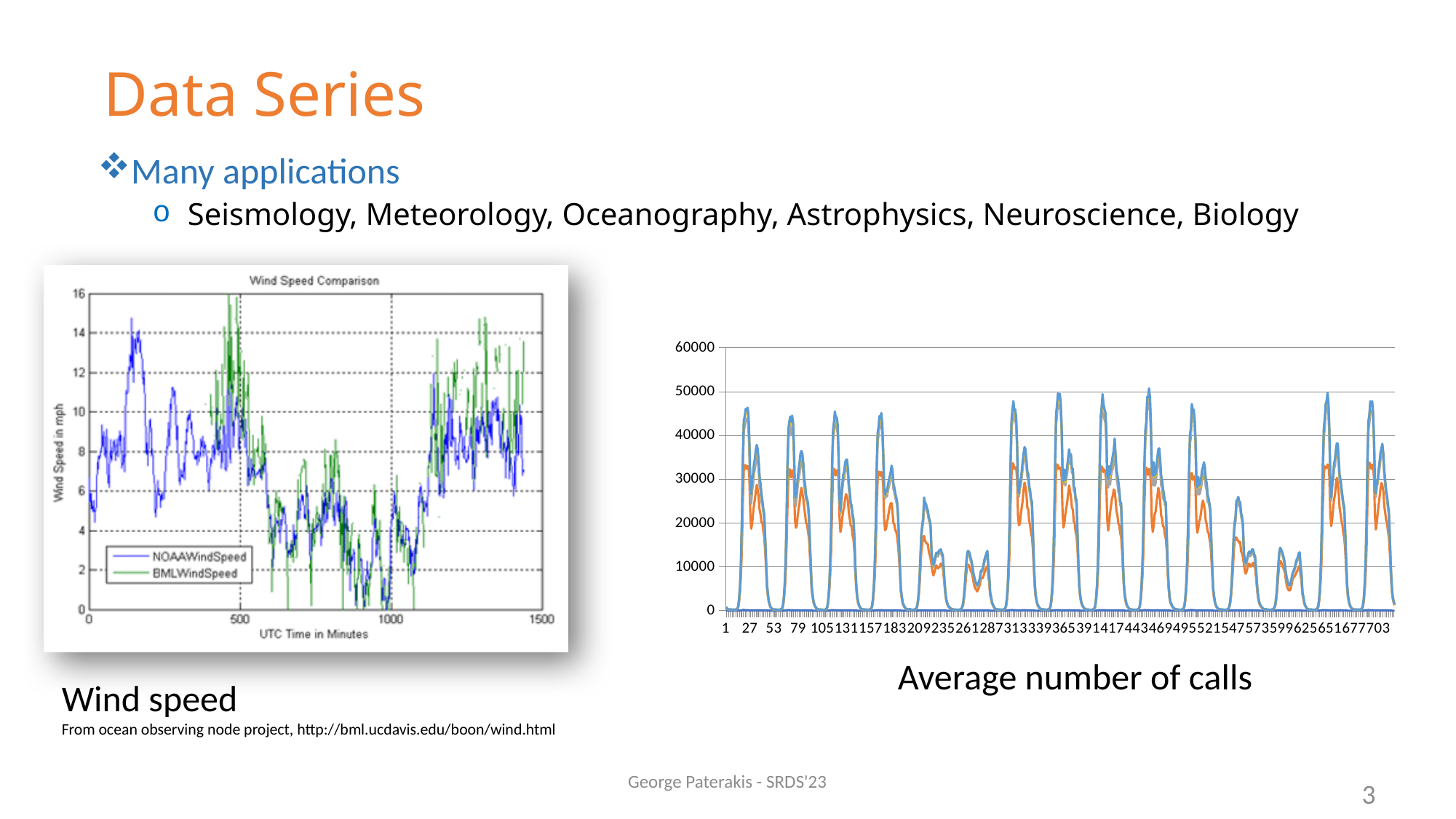
How many series does the legend of the Wind Speed Comparison chart list? 2 What kind of chart is the Average number of calls chart on the right? line chart What is the title printed above the left chart? Wind Speed Comparison What are the two legend entries in the Wind Speed Comparison chart? NOAAWindSpeed and BMLWindSpeed In the Average number of calls chart, is the highest peak of the orange line greater or less than 40000? less In the Wind Speed Comparison chart, is the highest value of the NOAAWindSpeed line greater or less than 12? greater In the Average number of calls chart, is the lowest value of the blue line greater or less than 10000? less What kind of chart is the Wind Speed Comparison chart on the left? line chart In the Average number of calls chart, which line reaches higher peaks, the blue line or the orange line? blue line